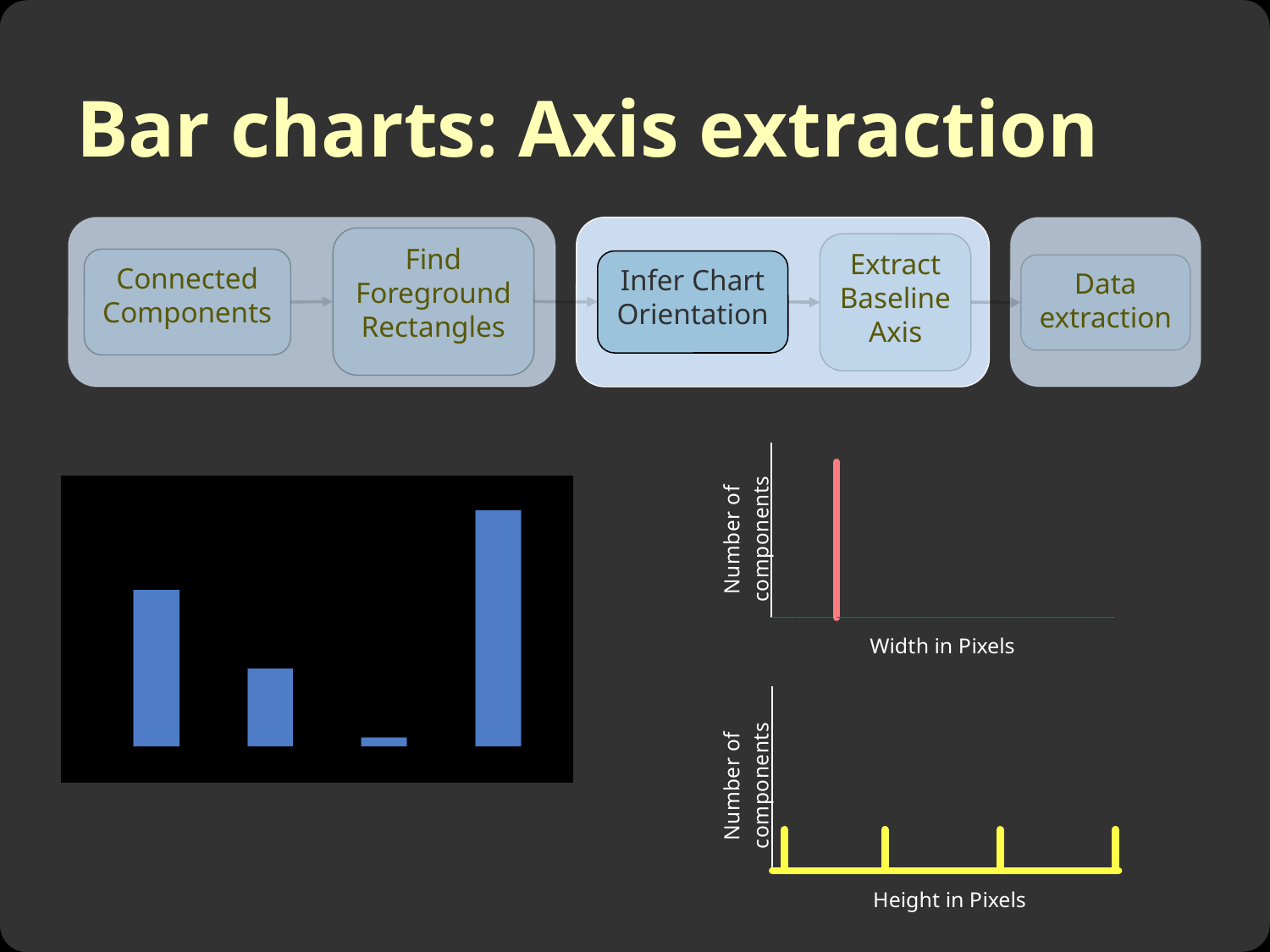
What is the x-axis label of the lower chart on the right of the slide? Height in Pixels In the bar chart on the left of the slide, is the second bar or the fourth bar taller? the fourth bar In the bar chart on the left of the slide, is the first bar or the second bar taller? the first bar What is the x-axis label of the upper chart on the right of the slide? Width in Pixels How many spikes are plotted in the lower chart on the right of the slide (Height in Pixels)? 4 How many bars are in the bar chart on the left of the slide? 4 In the bar chart on the left of the slide, do the bar heights consistently rise from left to right? No, they fall for the first three bars and then rise sharply at the fourth How many spikes are plotted in the upper chart on the right of the slide (Width in Pixels)? 1 What colour are the bars in the bar chart on the left of the slide? blue In the bar chart on the left of the slide, which bar is the tallest? the fourth (rightmost) bar What kind of chart is shown on the left of the slide with the black background? bar chart In the bar chart on the left of the slide, which bar is the shortest? the third bar